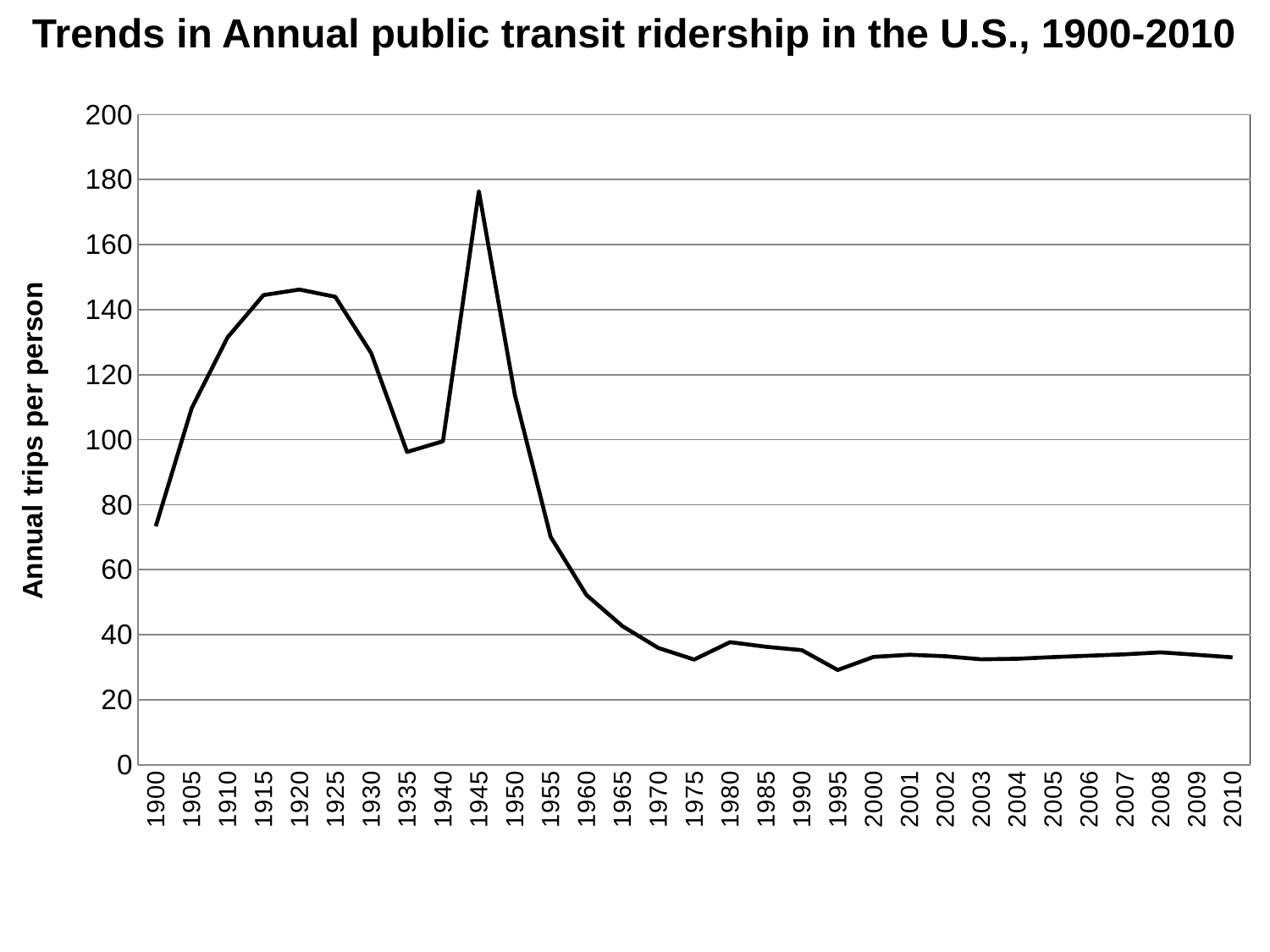
Which year has the larger value, 1960 or 1970? 1960 In which year is annual trips per person highest? 1945 Is the value for 1920 greater or less than 140? greater What is the title of the chart? Trends in Annual public transit ridership in the U.S., 1900-2010 Is the value for 1900 greater or less than 80? less What is the label of the vertical axis? Annual trips per person How many years are plotted along the x axis? 31 What kind of chart is shown on the slide? line chart Is the value for 1945 greater or less than 160? greater Do the values rise or fall between 1945 and 1975? fall